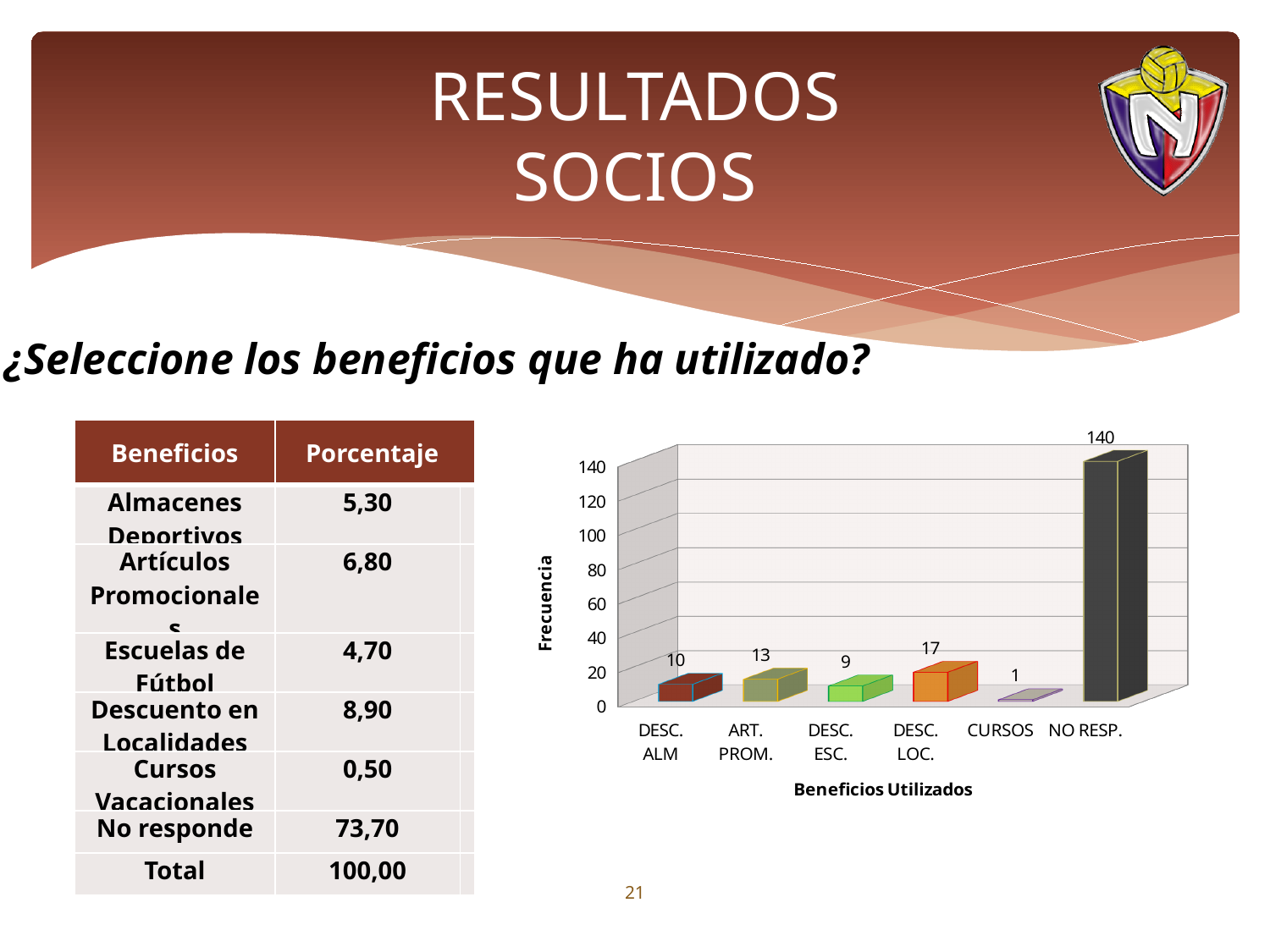
What is the value for ART. PROM.? 13 What kind of chart is shown? bar chart How many categories are shown on the x axis? 6 Which is larger, the value for ART. PROM. or the value for DESC. ESC.? ART. PROM. What is the value for DESC. ALM? 10 Which category has the lowest value? CURSOS What is the label of the vertical axis? Frecuencia What is the value for CURSOS? 1 Which category has the highest value? NO RESP. What is the value for DESC. LOC.? 17 What is the difference between the values for NO RESP. and DESC. LOC.? 123 What is the value for DESC. ESC.? 9